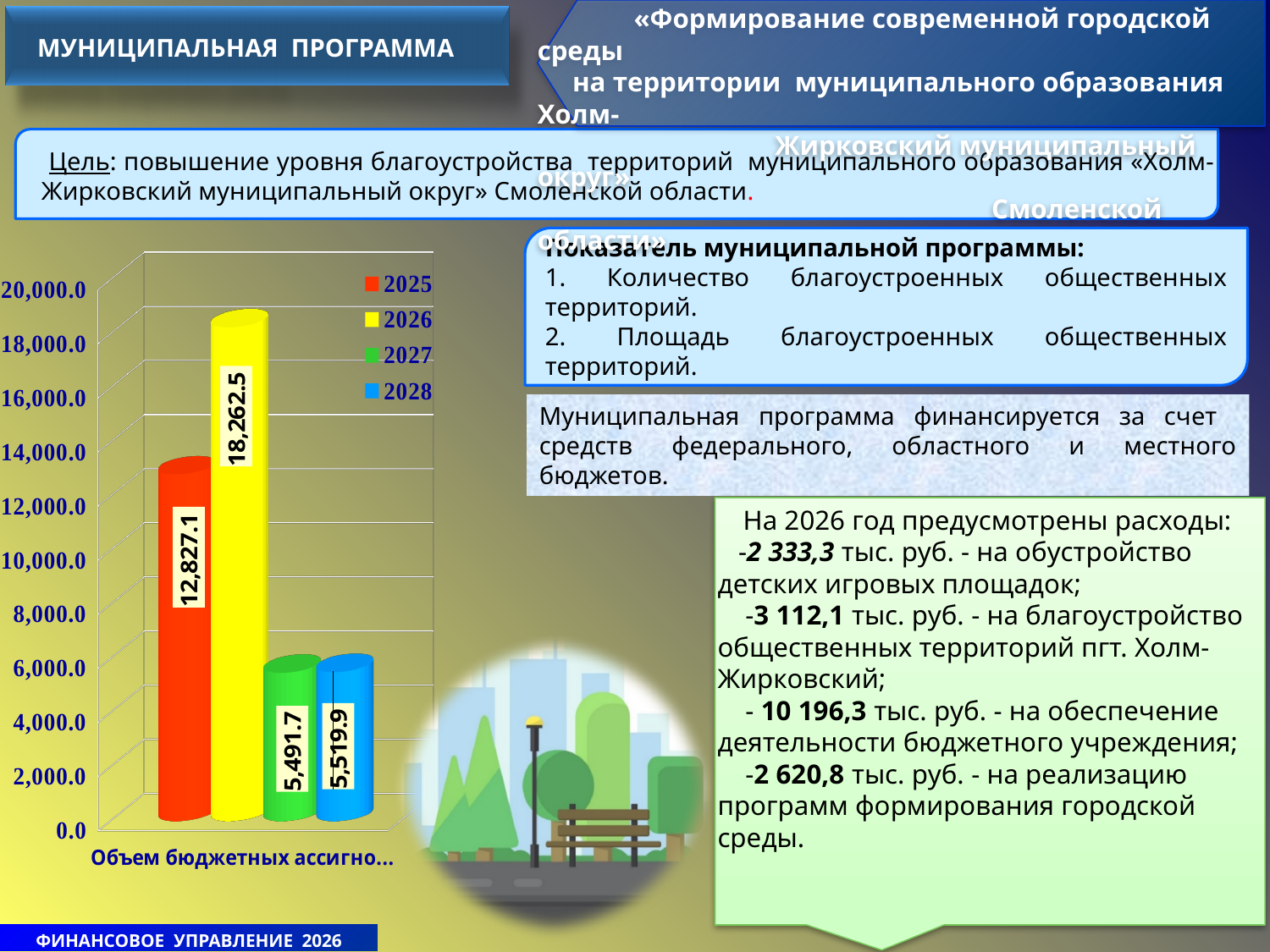
What is the value shown for 2025 in the chart? 12,827.1 How many series does the chart legend list? 4 Which is larger, the value for 2025 or the value for 2027? 2025 What is the value shown for 2028 in the chart? 5,519.9 Is the value for 2026 greater or less than 16,000.0? greater What is the difference between the values for 2025 and 2027? 7,335.4 What is the value shown for 2027 in the chart? 5,491.7 Which year has the highest value in the chart? 2026 What is the difference between the values for 2026 and 2025? 5,435.4 What colour is the bar for 2026 in the chart? yellow What kind of chart is shown on the slide? bar chart What is the value shown for 2026 in the chart? 18,262.5